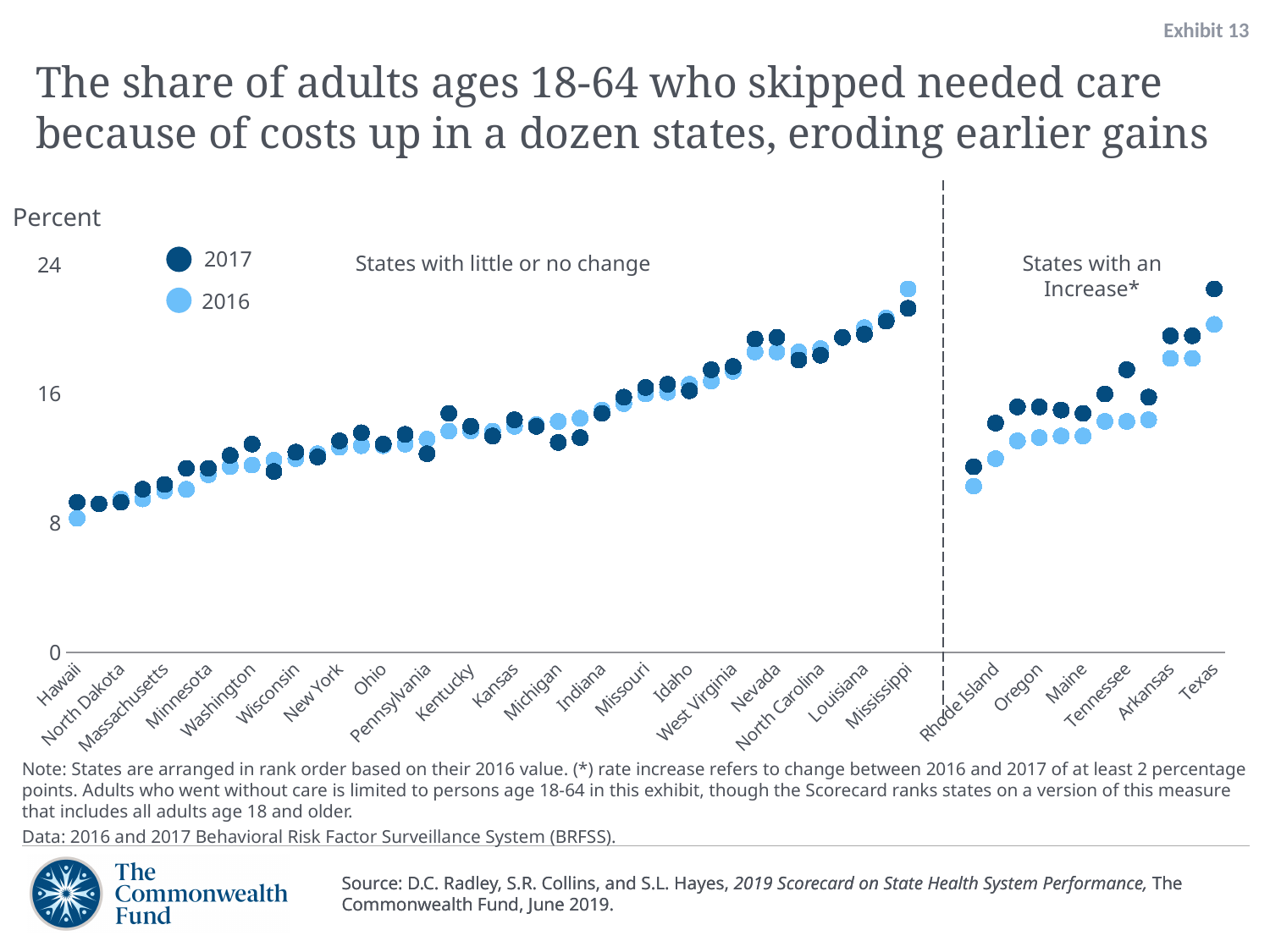
Is the 2016 value for Rhode Island greater or less than 16? less What is the label on the vertical axis? Percent Which state has the lowest 2016 value? Hawaii Is the 2017 value for Texas greater or less than 16? greater What kind of chart is shown on the slide? Dot (scatter) chart Which is larger, the 2017 value for Texas or the 2017 value for Rhode Island? Texas Do the values for the states with little or no change rise or fall from left to right along the x axis? rise Is the 2017 value for Hawaii greater or less than 16? less Which state has the highest 2016 value? Mississippi Which two years are shown in the legend? 2017 and 2016 Which state has the highest 2017 value? Texas How many series does the legend list? 2